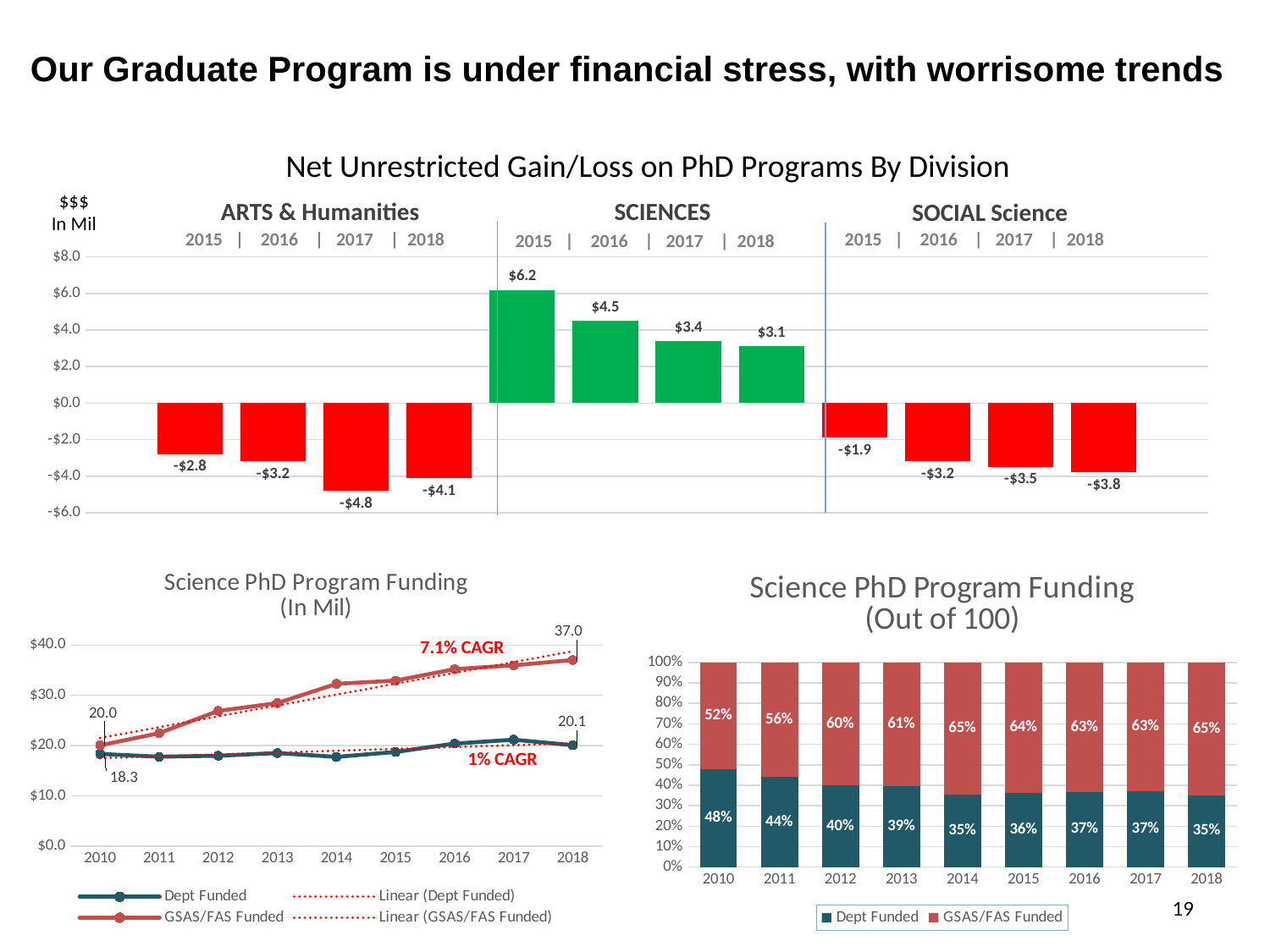
In the 'Net Unrestricted Gain/Loss on PhD Programs By Division' chart, what is the value for Arts & Humanities in 2017? -$4.8 In the 'Science PhD Program Funding (Out of 100)' chart, what is the GSAS/FAS Funded share in 2013? 61% In the 'Science PhD Program Funding (In Mil)' chart, what is the Dept Funded value in 2010? 18.3 In the 'Net Unrestricted Gain/Loss on PhD Programs By Division' chart, what is the difference between the Sciences values for 2015 and 2018? $3.1 In the 'Science PhD Program Funding (In Mil)' chart, what is the GSAS/FAS Funded value in 2018? 37.0 In the 'Science PhD Program Funding (Out of 100)' chart, which year has the highest Dept Funded share? 2010 In the 'Net Unrestricted Gain/Loss on PhD Programs By Division' chart, what is the value for Sciences in 2015? $6.2 In the 'Net Unrestricted Gain/Loss on PhD Programs By Division' chart, which year has the lowest value for Social Science? 2018 In the 'Net Unrestricted Gain/Loss on PhD Programs By Division' chart, do the Sciences values rise or fall from 2015 to 2018? fall In the 'Net Unrestricted Gain/Loss on PhD Programs By Division' chart, which is larger: Arts & Humanities in 2015 or Social Science in 2015? Social Science in 2015 In the 'Science PhD Program Funding (In Mil)' chart, what CAGR is shown for the GSAS/FAS Funded series? 7.1% CAGR What kind of chart is 'Science PhD Program Funding (In Mil)'? line chart